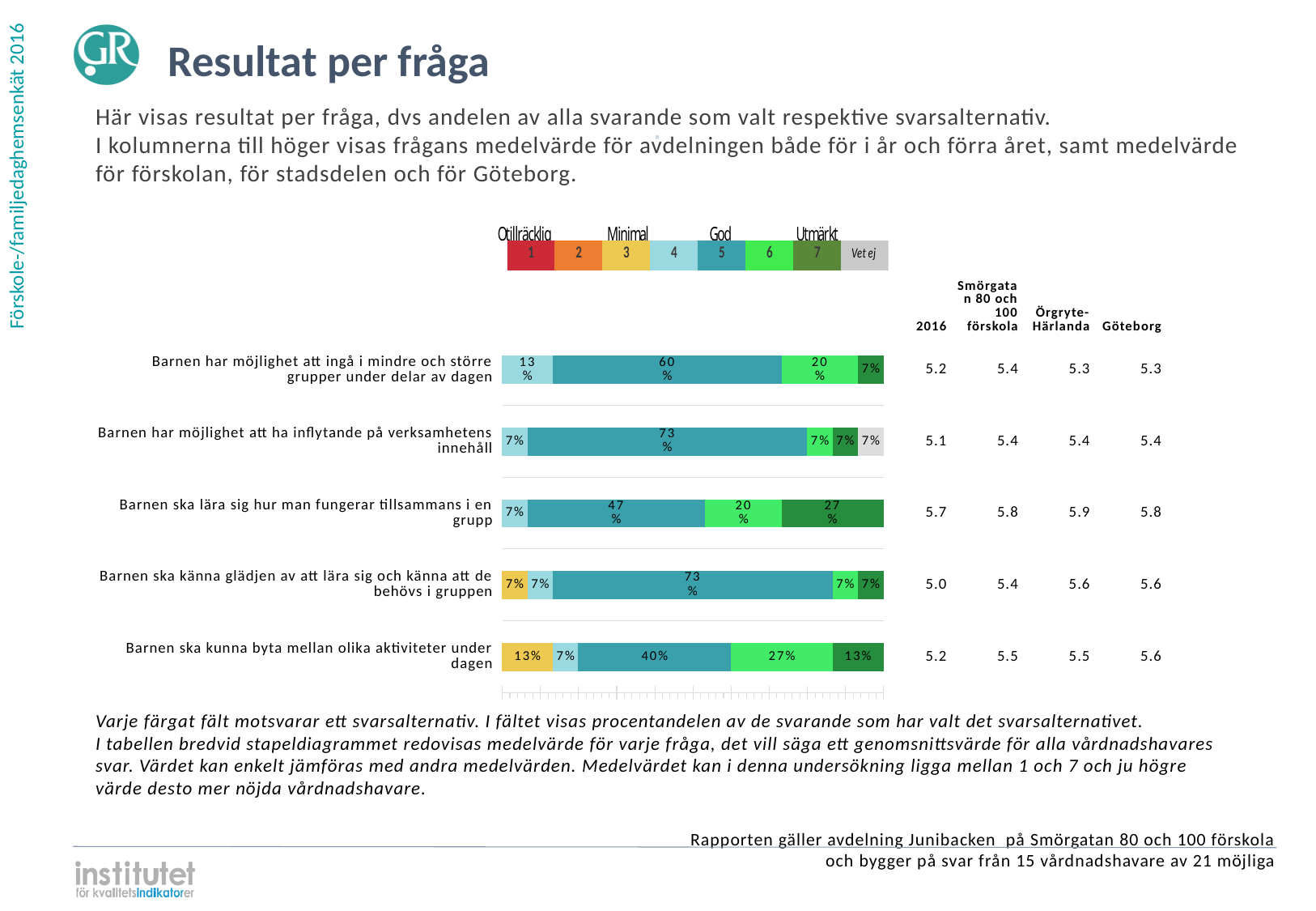
For 'Barnen ska kunna byta mellan olika aktiviteter under dagen', which is larger: the share for option 5 or the share for option 6? Option 5 What percentage of respondents chose option 7 for 'Barnen ska lära sig hur man fungerar tillsammans i en grupp'? 27% What percentage of respondents chose option 5 for 'Barnen har möjlighet att ingå i mindre och större grupper under delar av dagen'? 60% What is the 2016 mean value shown for 'Barnen ska lära sig hur man fungerar tillsammans i en grupp'? 5.7 What kind of chart is used to show the results per question? Stacked bar chart What percentage of respondents chose option 3 for 'Barnen ska kunna byta mellan olika aktiviteter under dagen'? 13% How many answer options does the legend above the chart list, including 'Vet ej'? 8 How many questions (bars) are shown in the chart? 5 Which answer option has the largest share for 'Barnen ska känna glädjen av att lära sig och känna att de behövs i gruppen'? 5 What label does the legend give to answer option 7? Utmärkt What is the difference between the option 5 share and the option 6 share for 'Barnen ska lära sig hur man fungerar tillsammans i en grupp'? 27% What percentage of respondents answered 'Vet ej' for 'Barnen har möjlighet att ha inflytande på verksamhetens innehåll'? 7%